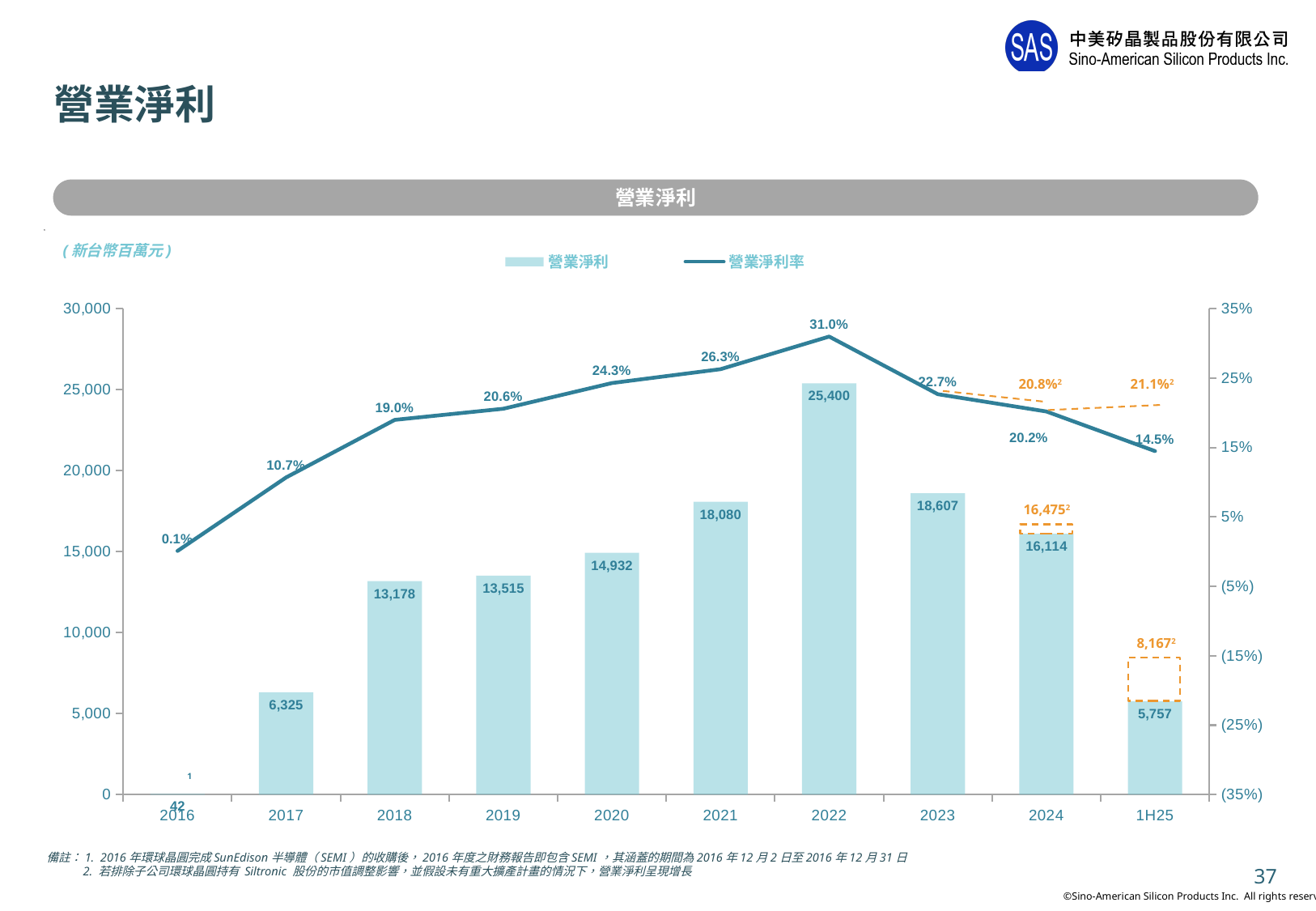
Which is larger, the 營業淨利 for 2019 or for 2018? 2019 Which year has the lowest 營業淨利率? 2016 What kind of chart is this? Combined bar and line chart Which year has the highest 營業淨利? 2022 Does the 營業淨利率 rise or fall from 2016 to 2022? Rise What is the 營業淨利率 for 2021? 26.3% What is the difference in 營業淨利 between 2023 and 2024? 2,493 What is the 營業淨利 value for 2022? 25,400 What is the 營業淨利 value for 1H25? 5,757 What is the adjusted 營業淨利 value shown in orange for 2024? 16,475 How many categories are shown on the x axis? 10 How many series does the legend list? 2